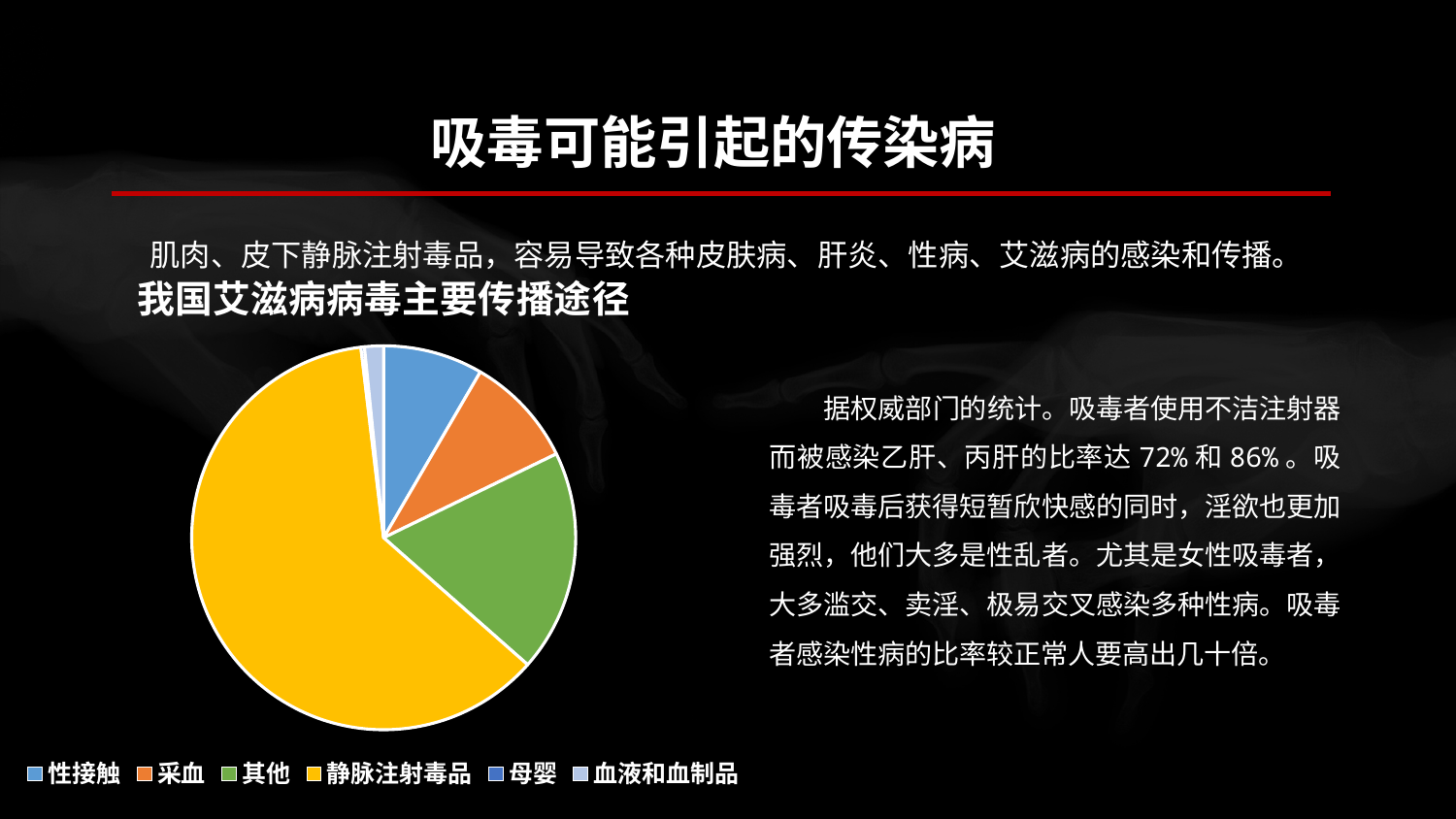
What is the title of the pie chart? 我国艾滋病病毒主要传播途径 Which slice is larger, 性接触 or 血液和血制品? 性接触 What colour is the 静脉注射毒品 slice in the pie chart? yellow How many entries does the legend of the pie chart list? 6 Which slice is larger, 静脉注射毒品 or 其他? 静脉注射毒品 Which category has the largest slice in the pie chart? 静脉注射毒品 What kind of chart is shown on the slide? pie chart Which slice is larger, 其他 or 性接触? 其他